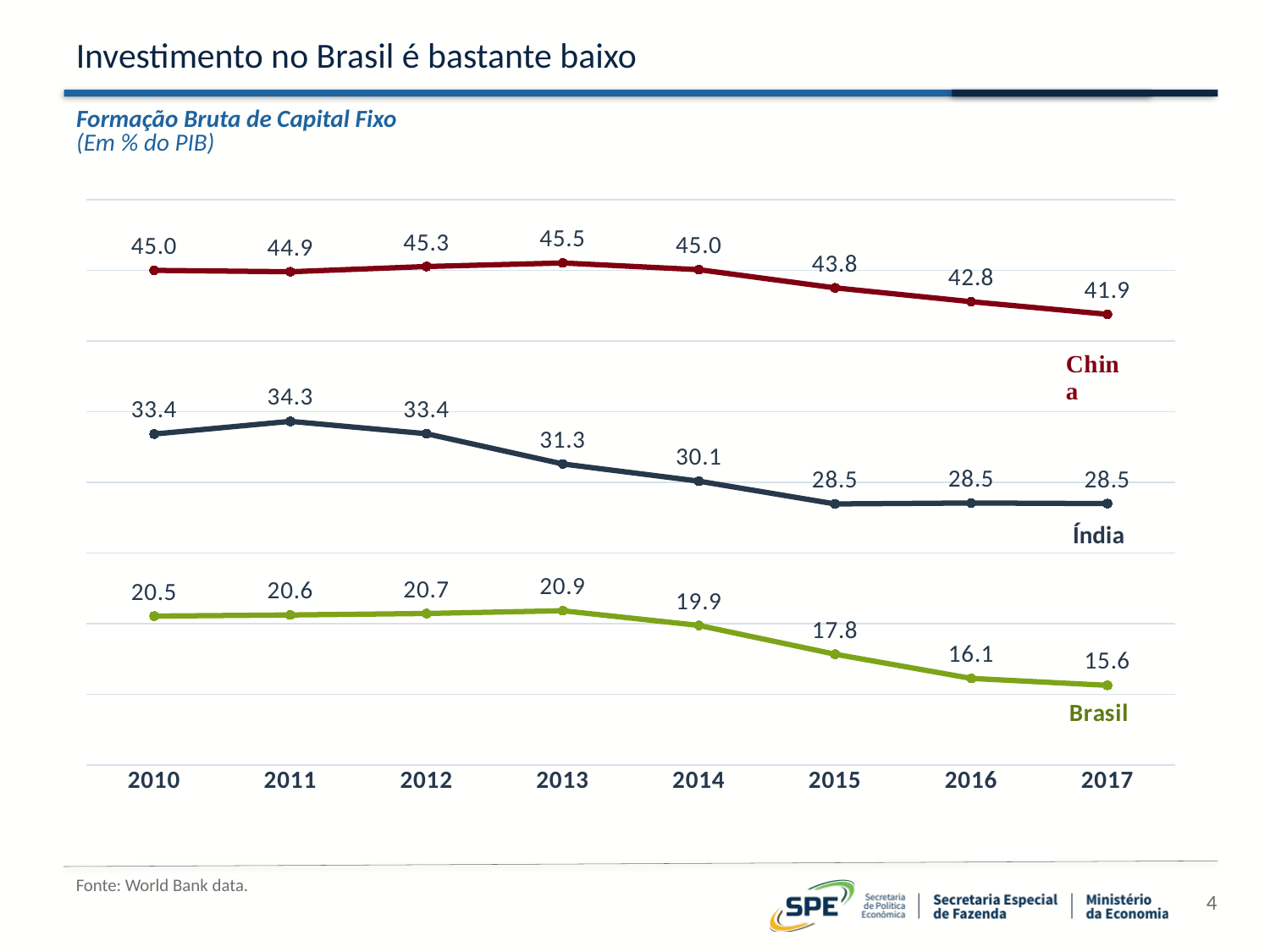
What kind of chart is shown on the slide? Line chart Does Brazil's value rise or fall from 2013 to 2017? Fall What was India's value in 2014? 30.1 Which was higher in 2011, India's value or Brazil's value? India In which year did China record its lowest value? 2017 What is the difference between China's and Brazil's values in 2010? 24.5 By how much did Brazil's value fall from 2013 to 2017? 5.3 How many countries (series) are plotted on the chart? 3 In which year did Brazil reach its highest value? 2013 What was Brazil's gross fixed capital formation (% of GDP) in 2017? 15.6 How many years are shown on the x axis? 8 What was China's value in 2013? 45.5